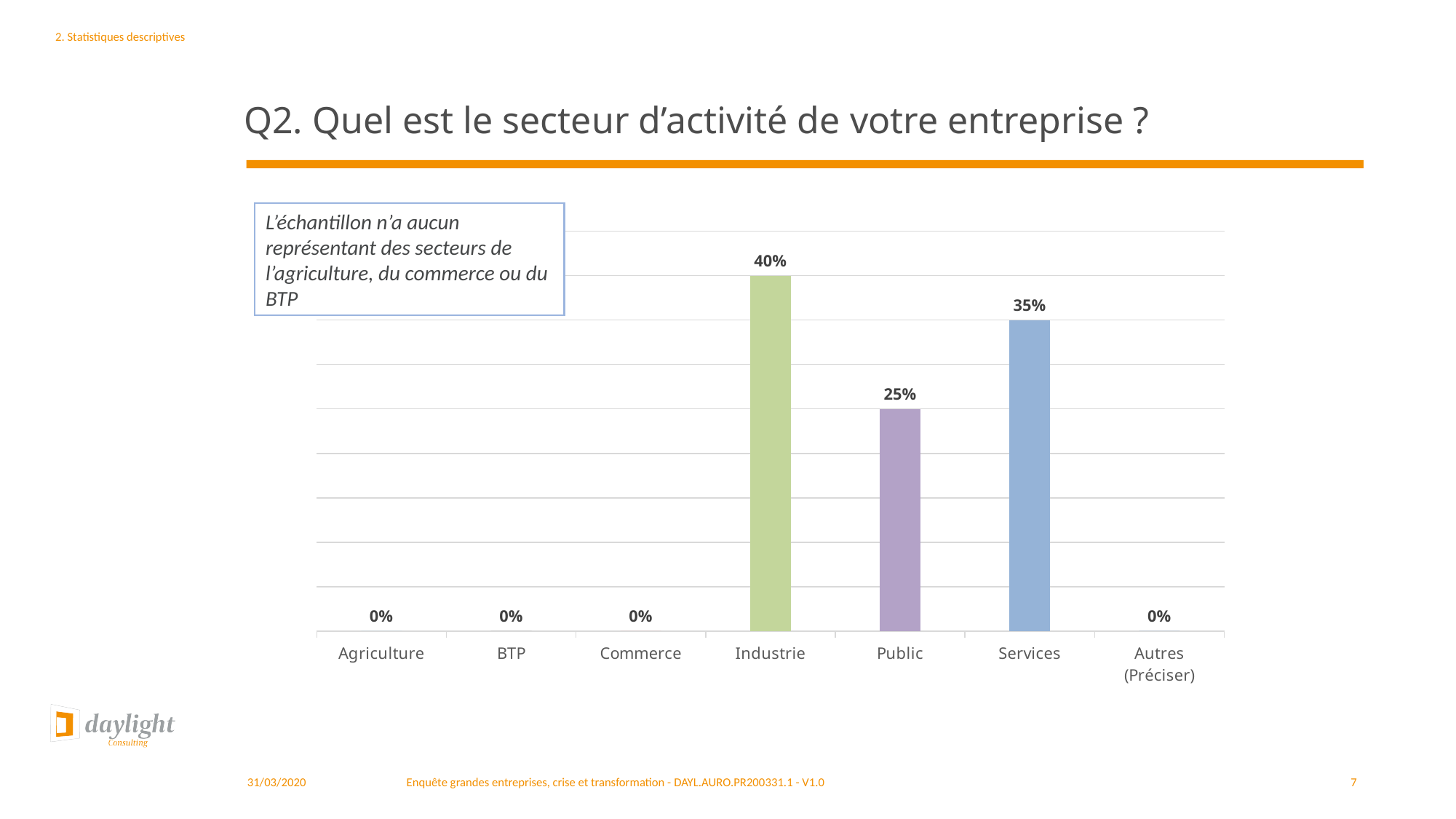
What kind of chart is shown on the slide? Bar chart What is the value for Agriculture? 0% What is the value for Public? 25% Which is larger, the value for Public or the value for Services? Services What is the difference between the values for Services and Public? 10% How many categories are shown on the x axis? 7 What is the value for Industrie? 40% What is the value for Services? 35% What is the title of the slide? Q2. Quel est le secteur d’activité de votre entreprise ? What is the difference between the values for Industrie and Services? 5% Which category has the highest value? Industrie How many categories have a value of 0%? 4